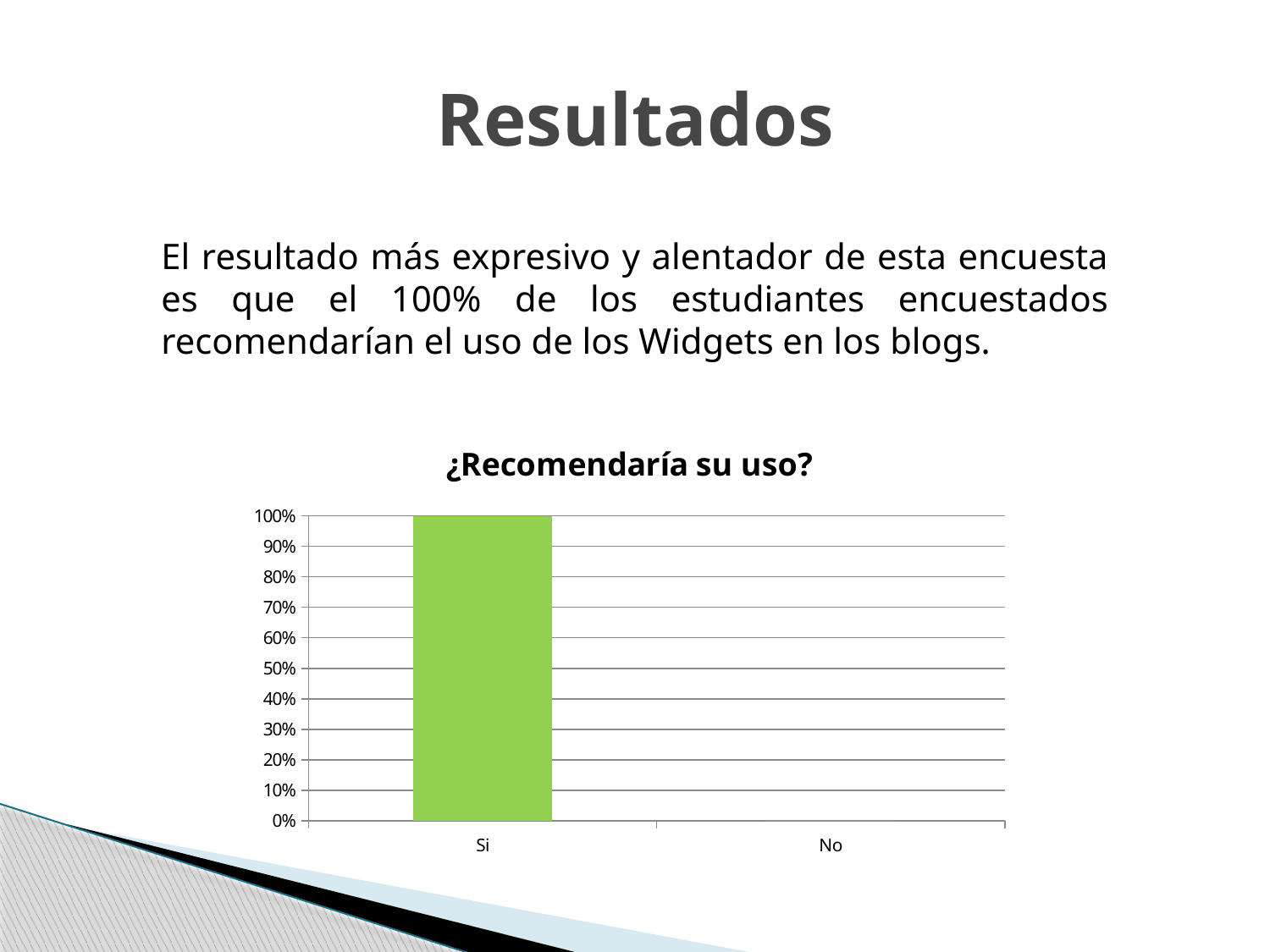
What is the title of the chart? ¿Recomendaría su uso? Which category has the lowest value in the chart? No Is the value for Si greater or less than 50%? greater What is the difference between the value for Si and the value for No? 100% How many categories are shown on the x axis of the chart? 2 What is the highest tick value shown on the y axis of the chart? 100% What kind of chart is shown on the slide? bar chart Which category has the highest value in the chart? Si What is the value for Si in the chart? 100% Which is larger, the value for Si or the value for No? Si What is the value for No in the chart? 0% Do the values rise or fall from Si to No along the x axis? fall